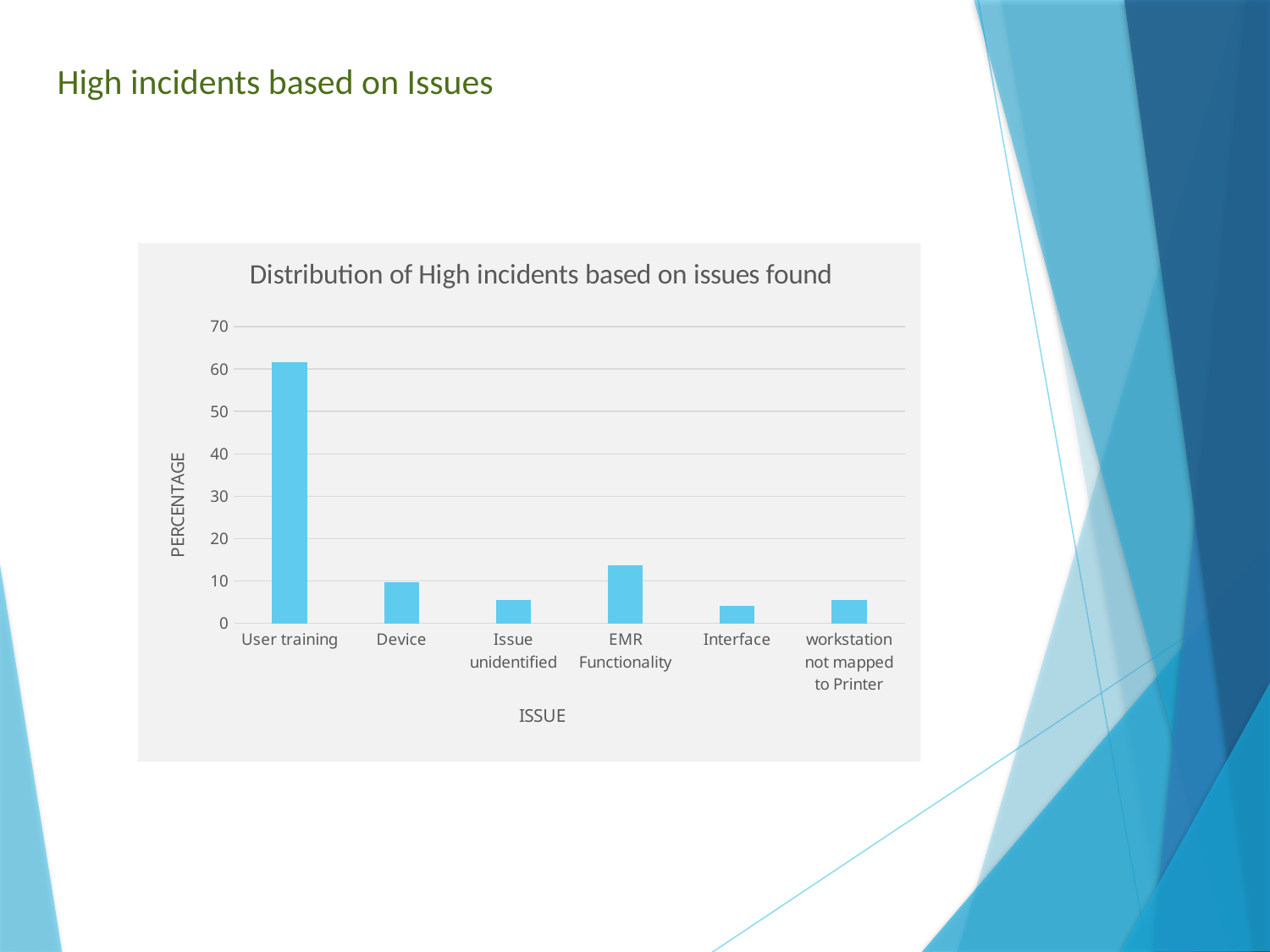
Which issue has the highest percentage of high incidents? User training Is the value for Issue unidentified greater or less than 10? less Which is larger, the value for EMR Functionality or the value for Device? EMR Functionality What is the title of the chart? Distribution of High incidents based on issues found Which is larger, the value for User training or the value for EMR Functionality? User training What is the label on the vertical axis of the chart? PERCENTAGE What kind of chart is shown on the slide? bar chart Is the value for Interface greater or less than 10? less Is the value for User training greater or less than 50? greater How many issue categories are plotted on the chart? 6 Which is larger, the value for Device or the value for Interface? Device